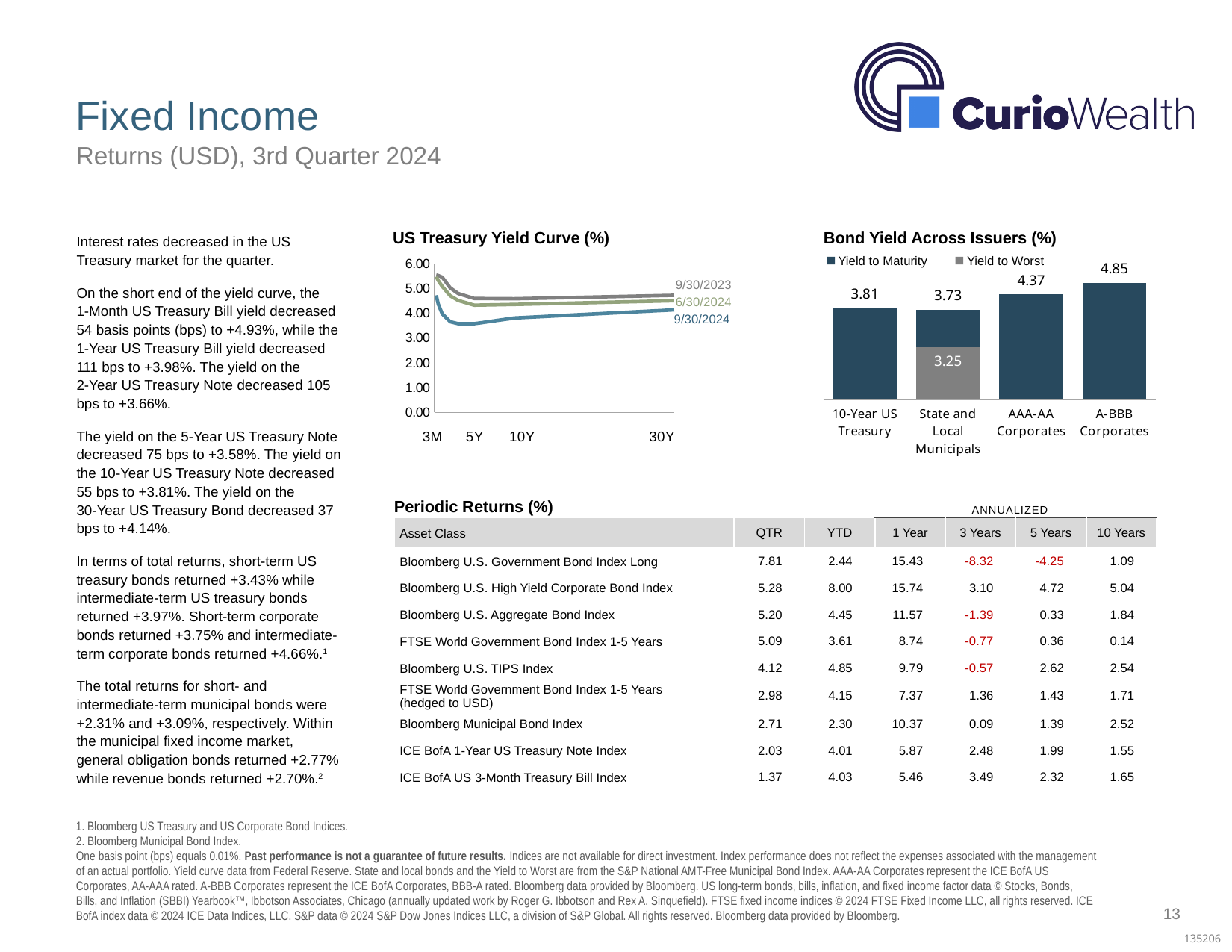
In the US Treasury Yield Curve (%) chart, which dated series is plotted lowest across the curve? 9/30/2024 How many series does the legend of the Bond Yield Across Issuers (%) chart list? 2 What kind of chart is the US Treasury Yield Curve (%) chart? Line chart In the US Treasury Yield Curve (%) chart, is the 9/30/2023 yield at 3M greater or less than 5.00? greater How many issuer categories are shown in the Bond Yield Across Issuers (%) chart? 4 In the US Treasury Yield Curve (%) chart, is the 9/30/2024 yield at 5Y greater or less than 4.00? less In the Bond Yield Across Issuers (%) chart, what is the Yield to Maturity for AAA-AA Corporates? 4.37 In the Bond Yield Across Issuers (%) chart, which issuer category has the lowest Yield to Maturity? State and Local Municipals In the Bond Yield Across Issuers (%) chart, which issuer category has the highest Yield to Maturity? A-BBB Corporates In the Bond Yield Across Issuers (%) chart, which is larger: the Yield to Maturity for AAA-AA Corporates or for the 10-Year US Treasury? AAA-AA Corporates In the Bond Yield Across Issuers (%) chart, what is the Yield to Worst for State and Local Municipals? 3.25 In the Bond Yield Across Issuers (%) chart, what is the difference between the Yield to Maturity of A-BBB Corporates and AAA-AA Corporates? 0.48